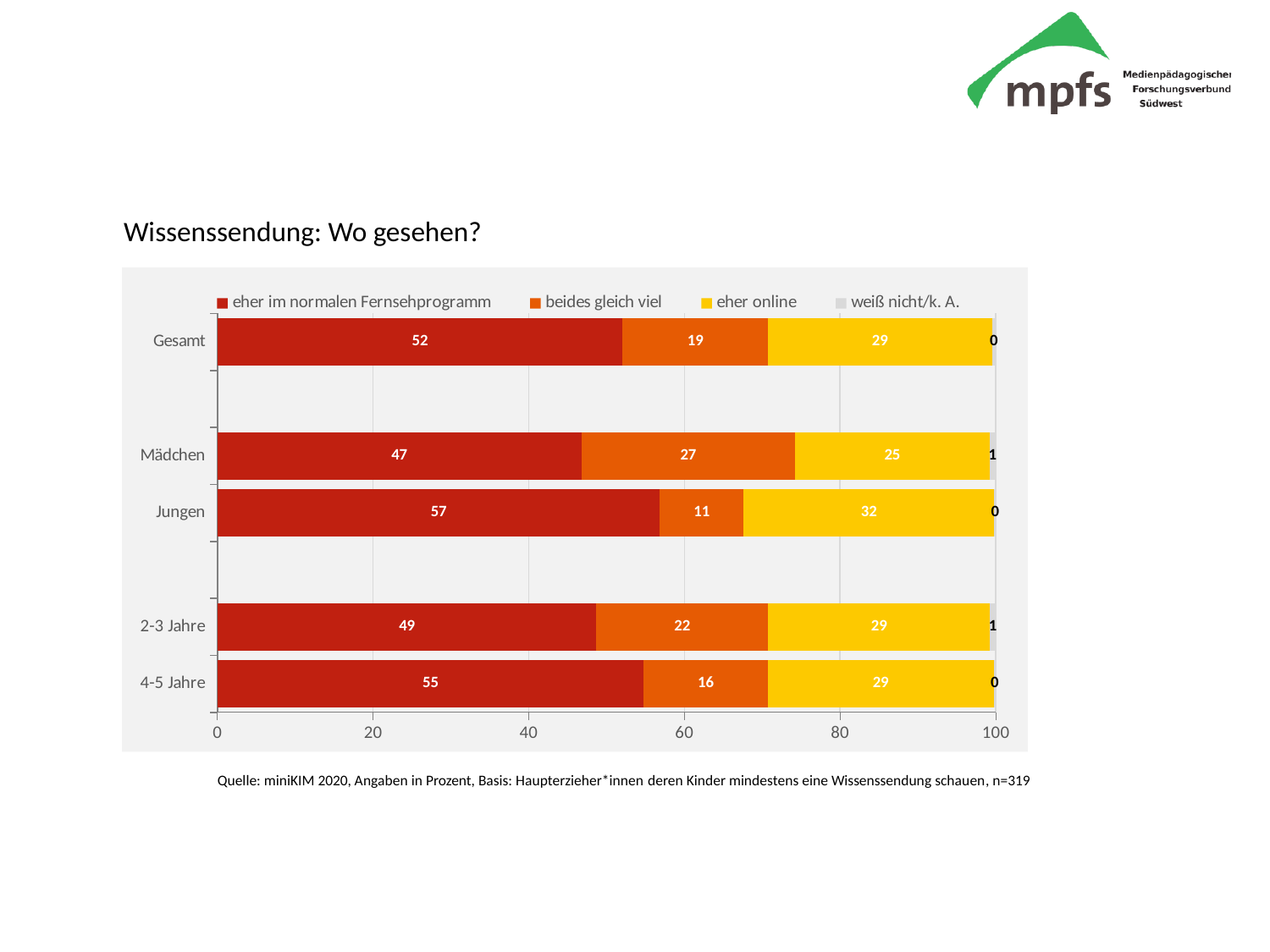
Which is larger: the "eher online" value for Mädchen or for Jungen? Jungen What is the value for "weiß nicht/k. A." for 2-3 Jahre? 1 What is the difference between the "eher im normalen Fernsehprogramm" values for Jungen and Mädchen? 10 What is the total of the stacked bar for 2-3 Jahre? 101 How many series does the legend list? 4 How many categories are shown on the y axis? 5 What kind of chart is shown on the slide? stacked bar chart Which category has the highest value for "eher im normalen Fernsehprogramm"? Jungen What is the value for "beides gleich viel" for Mädchen? 27 Which category has the lowest value for "beides gleich viel"? Jungen What is the value for "eher online" for Jungen? 32 What is the value for "eher im normalen Fernsehprogramm" for Gesamt? 52